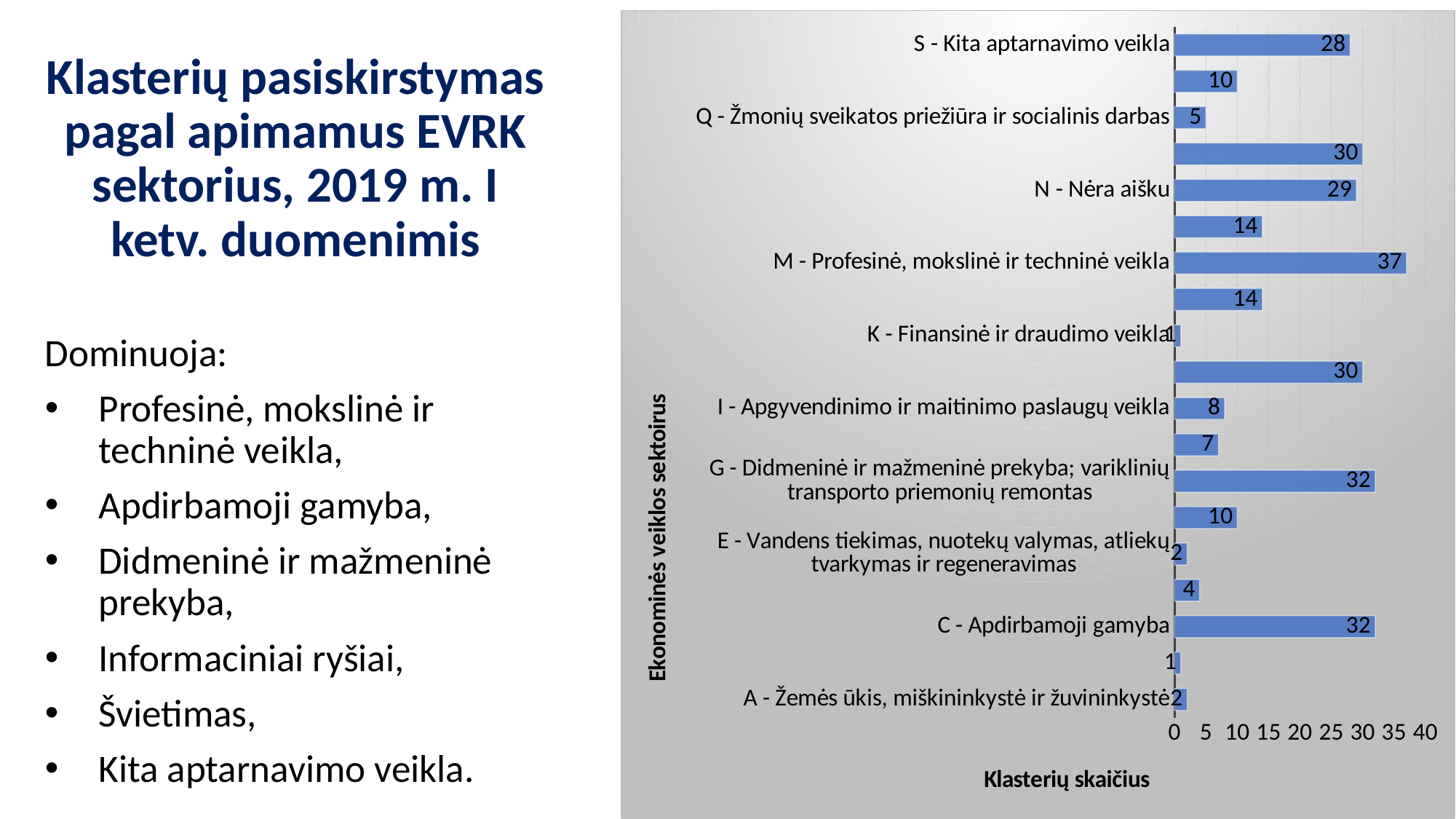
What is the difference between the values for M - Profesinė, mokslinė ir techninė veikla and S - Kita aptarnavimo veikla? 9 What is the value for M - Profesinė, mokslinė ir techninė veikla? 37 Which is larger, the value for N - Nėra aišku or the value for Q - Žmonių sveikatos priežiūra ir socialinis darbas? N - Nėra aišku What kind of chart is shown on the slide? bar chart What is the value for C - Apdirbamoji gamyba? 32 How many bars are plotted in the chart? 19 What is the value for S - Kita aptarnavimo veikla? 28 Which category has the highest value? M - Profesinė, mokslinė ir techninė veikla What is the title of the horizontal axis of the chart? Klasterių skaičius Is the value for M - Profesinė, mokslinė ir techninė veikla greater or less than 35? greater What is the value for I - Apgyvendinimo ir maitinimo paslaugų veikla? 8 What is the value for Q - Žmonių sveikatos priežiūra ir socialinis darbas? 5